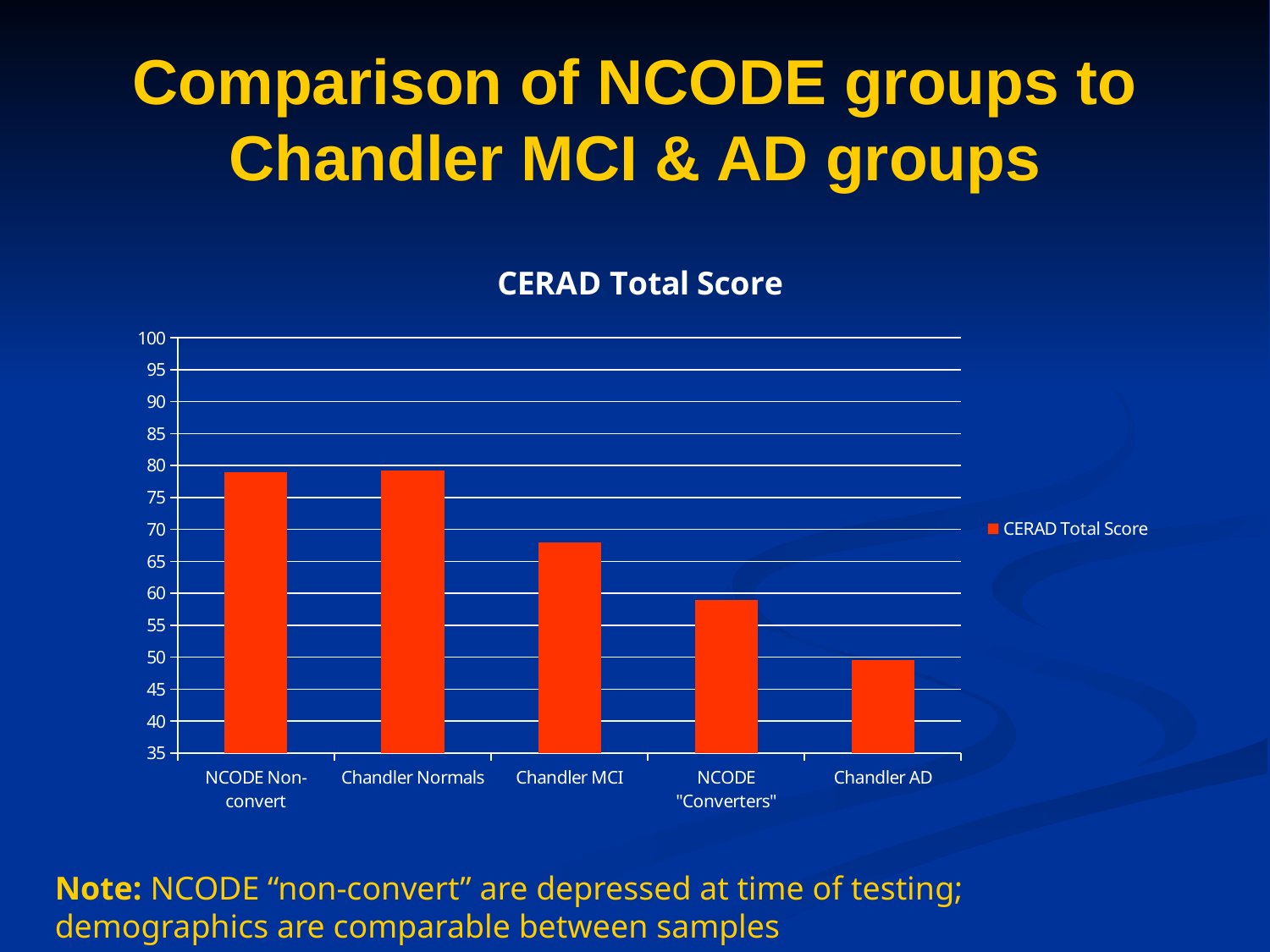
Is the CERAD Total Score for Chandler AD greater or less than 55? less How many series does the legend list? 1 Which has a higher CERAD Total Score, Chandler MCI or NCODE "Converters"? Chandler MCI Is the CERAD Total Score for Chandler MCI greater or less than 70? less Is the CERAD Total Score for NCODE "Converters" greater or less than 55? greater Which group has the lowest CERAD Total Score? Chandler AD How many groups (categories) are plotted on the x axis? 5 Which has a higher CERAD Total Score, Chandler Normals or Chandler AD? Chandler Normals Do the CERAD Total Scores generally rise or fall moving from left to right across the groups? fall What kind of chart is shown on the slide? bar chart What is the title of the chart? CERAD Total Score